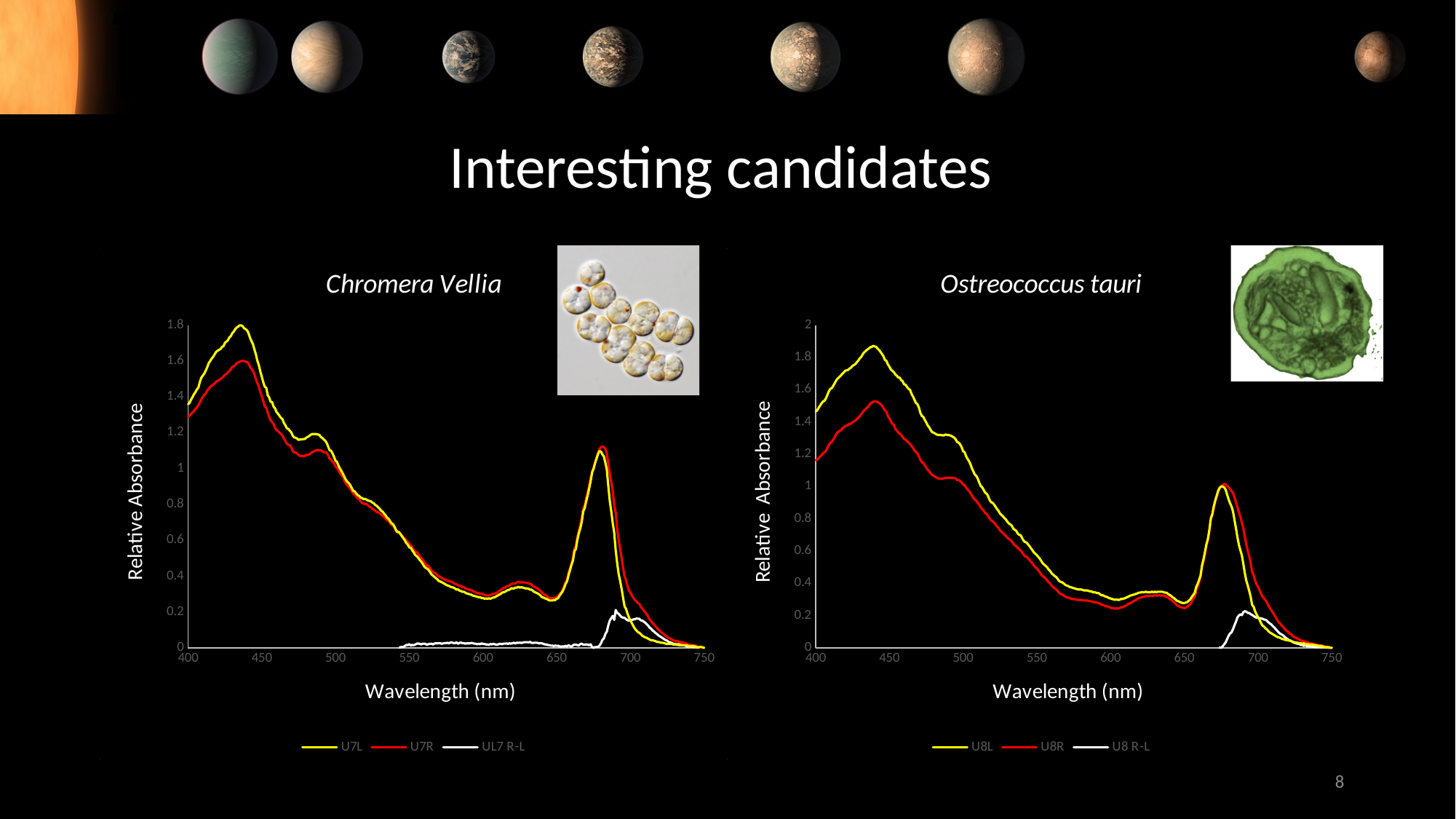
In the Chromera Vellia chart, at 450 nm, which is larger: U7L or U7R? U7L How many series does the legend of the Ostreococcus tauri chart list? 3 What are the legend entries of the Chromera Vellia chart? U7L, U7R, UL7 R-L What is the x-axis label of the Ostreococcus tauri chart? Wavelength (nm) In the Chromera Vellia chart, do the U7L values rise or fall between 450 nm and 600 nm? fall In the Chromera Vellia chart, which series reaches the highest relative absorbance? U7L In the Ostreococcus tauri chart, is the value of U8R at 600 nm greater or less than 0.4? less What kind of chart is the Chromera Vellia chart on the left? line chart In the Ostreococcus tauri chart, is the peak value of U8 R-L greater or less than 0.4? less In the Ostreococcus tauri chart, at 450 nm, which is larger: U8L or U8R? U8L In the Chromera Vellia chart, is the value of U7L at 600 nm greater or less than 0.6? less In the Ostreococcus tauri chart, which series reaches the highest relative absorbance? U8L